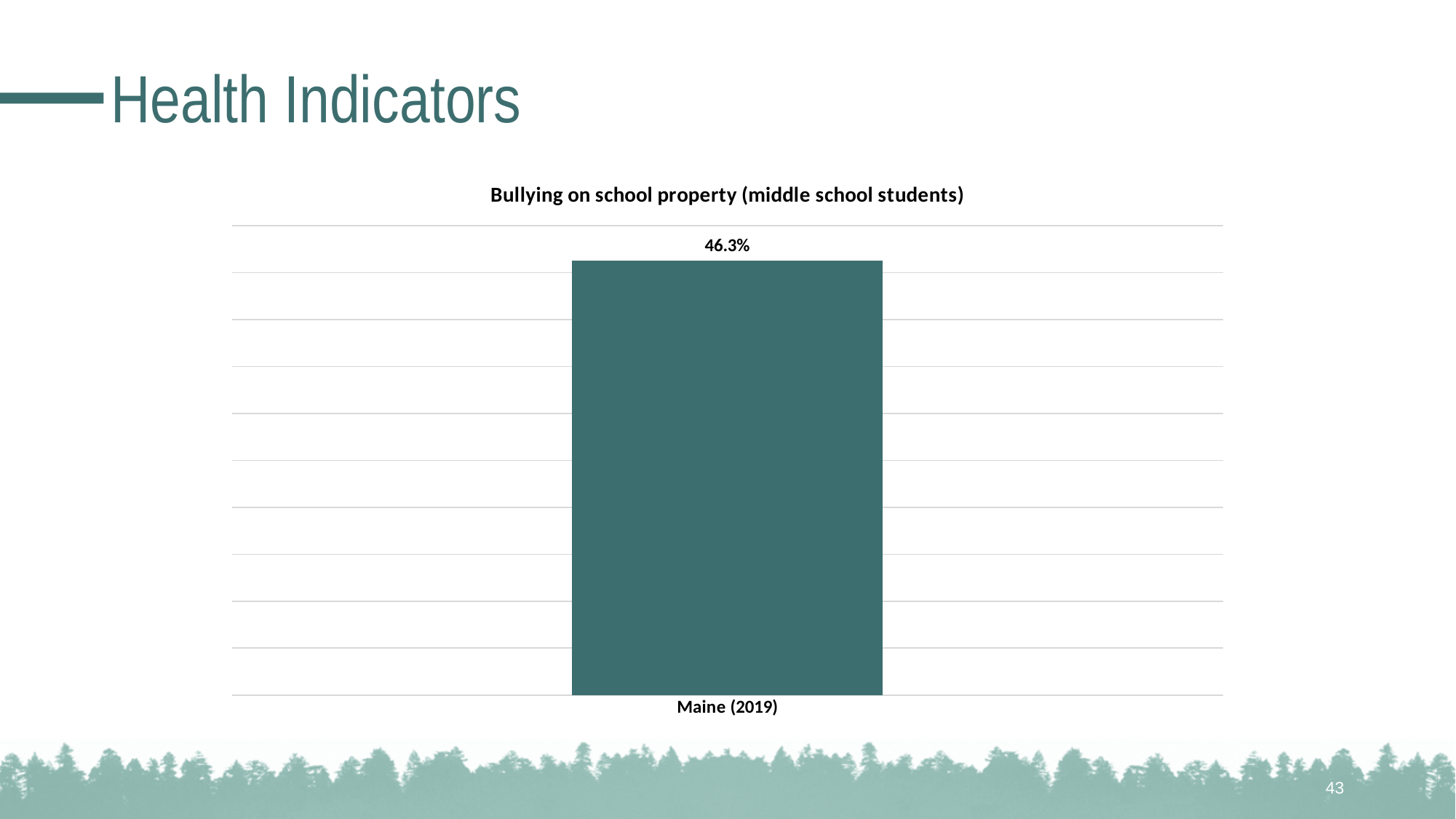
What is the value for Maine (2019) in the chart? 46.3% How many categories are plotted in the chart? 1 What is the label of the single category on the x axis? Maine (2019) What is the title of the chart? Bullying on school property (middle school students) What kind of chart is shown on the slide? bar chart Which category has the highest value in the chart? Maine (2019)